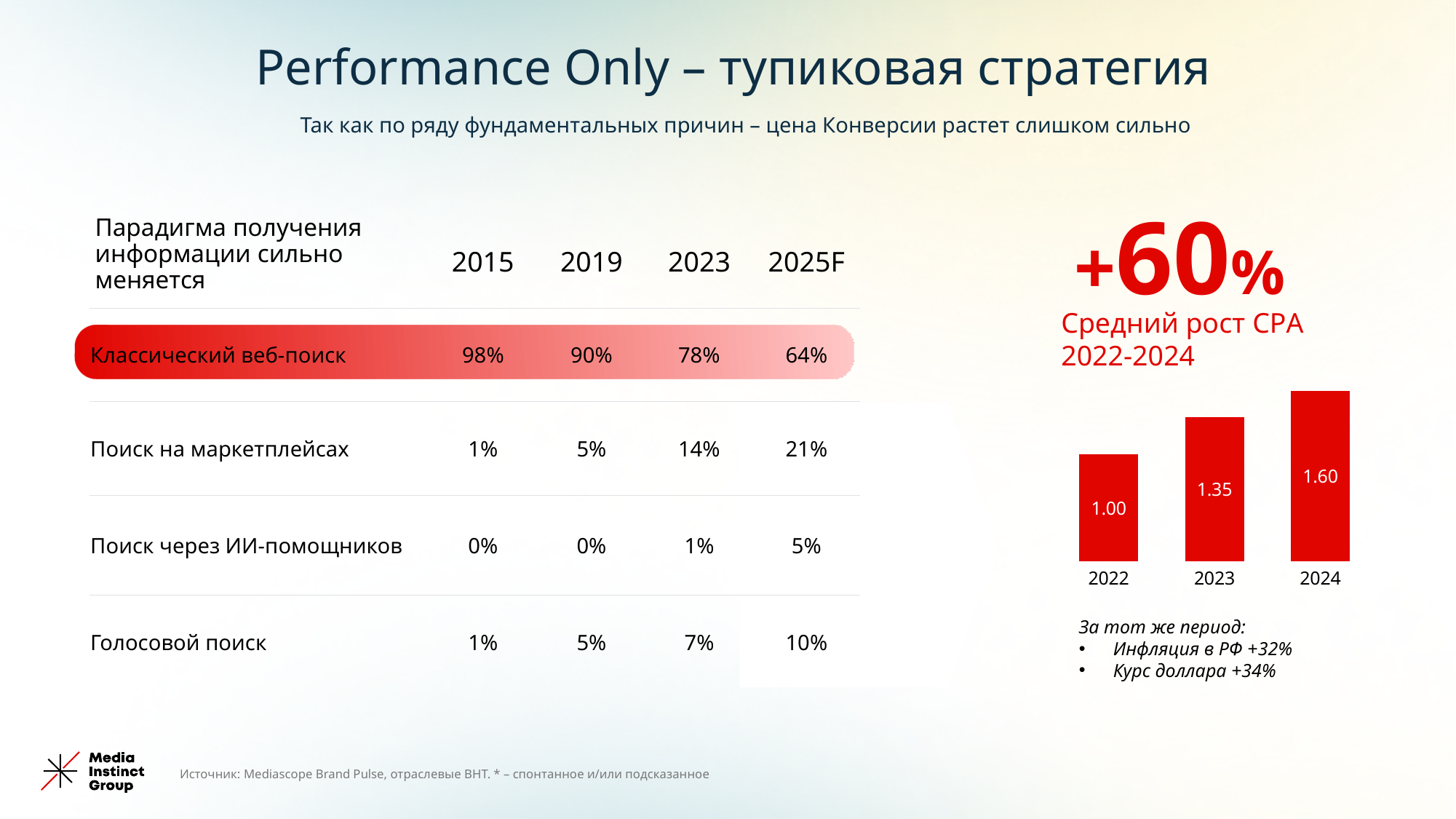
What type of chart is used to show CPA growth on the right of the slide? bar chart What is the value of the bar for 2022 in the CPA growth chart? 1.00 In the CPA growth chart, which is larger: the value for 2023 or the value for 2024? 2024 Do the values in the CPA growth chart rise or fall from 2022 to 2024? rise How many bars are shown in the CPA growth chart? 3 Which year has the lowest bar in the CPA growth chart? 2022 What is the value of the bar for 2023 in the CPA growth chart? 1.35 What is the difference between the 2024 and 2022 values in the CPA growth chart? 0.60 What is the value of the bar for 2024 in the CPA growth chart? 1.60 What is the difference between the 2023 and 2022 values in the CPA growth chart? 0.35 Which year has the highest bar in the CPA growth chart? 2024 What colour are the bars in the CPA growth chart? red